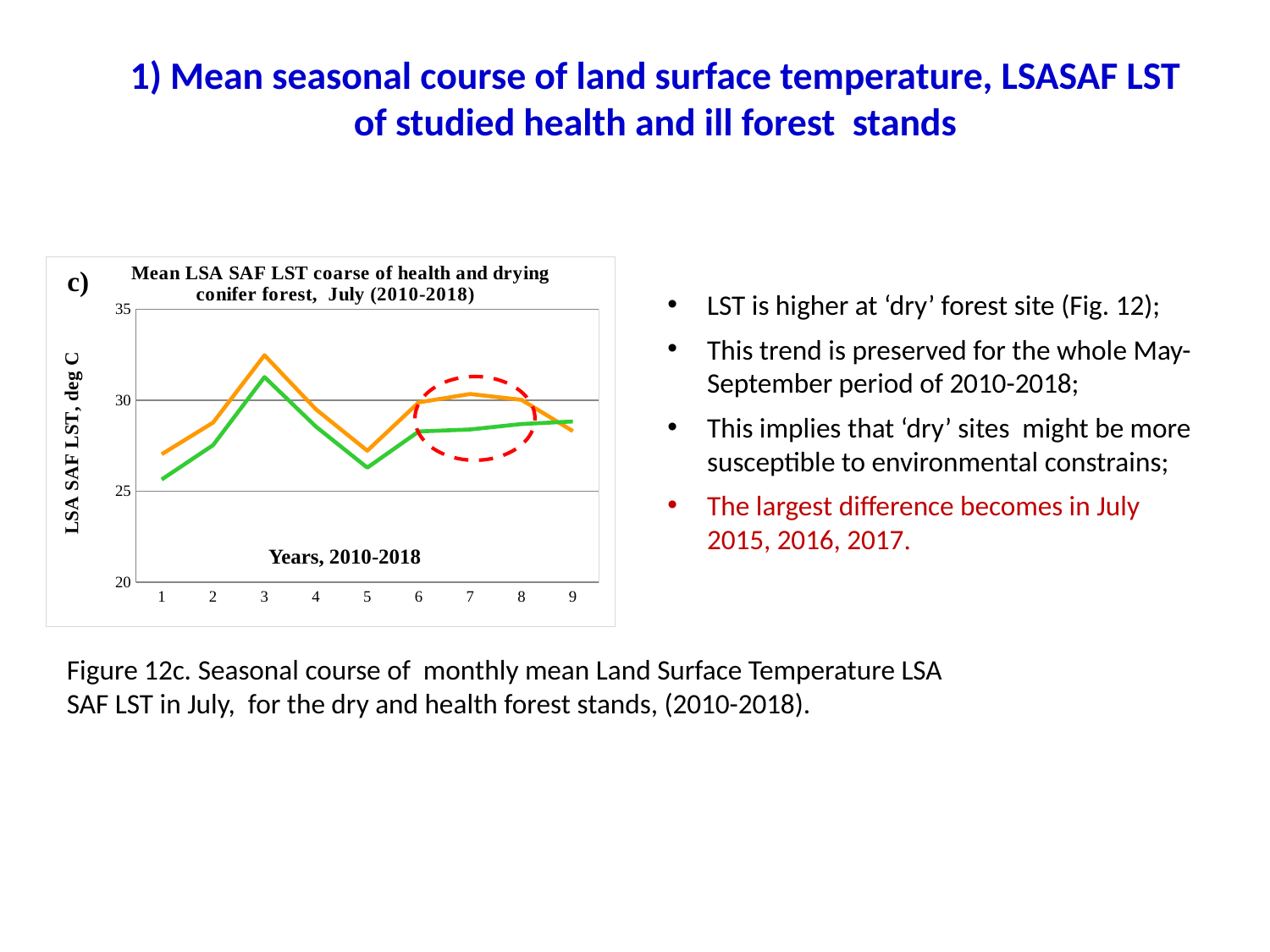
What is the label of the x axis of the chart? Years, 2010-2018 At point 1, which line has the higher value, the orange or the green? orange Is the value of the green line at point 1 greater or less than 25? greater What is the label of the y axis of the chart? LSA SAF LST, deg C Is the value of the green line at point 5 greater or less than 30? less At which x-axis point does the orange line reach its highest value? 3 Do the values of the orange line rise or fall from point 3 to point 5? fall How many lines are plotted on the chart? 2 Is the value of the orange line at point 3 greater or less than 30? greater How many points along the x axis (years) are plotted on the chart? 9 What kind of chart is shown on the slide? line chart At which x-axis point does the green line reach its lowest value? 1